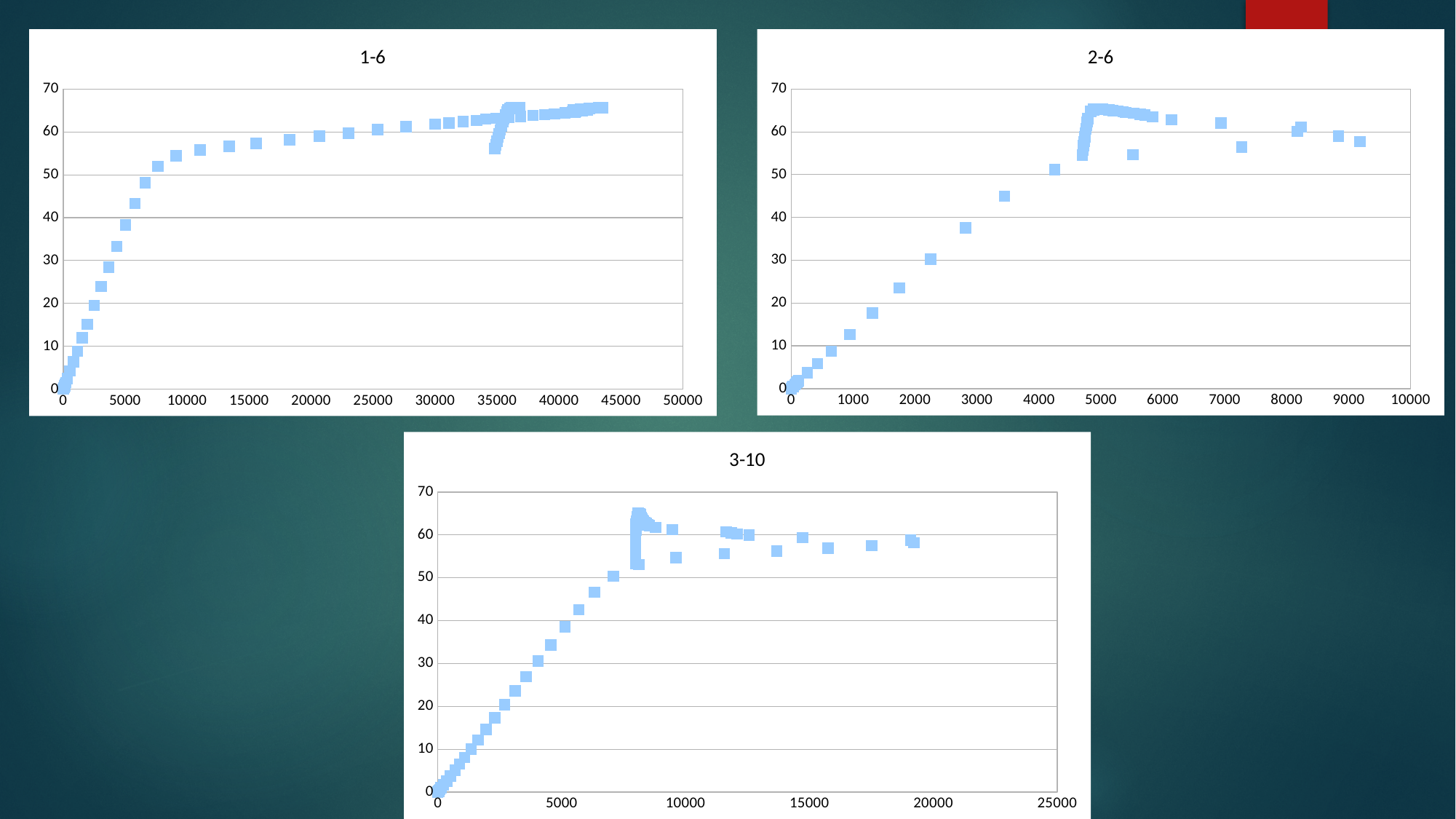
In the chart titled "1-6", what is the highest value shown on the x axis? 50000 In the chart titled "3-10", is the value at x = 10000 greater or less than 50? greater In the chart titled "3-10", is the value at x = 5000 greater or less than 50? less In the chart titled "2-6", do the values rise or fall as x increases from 0 to 4000? rise In the chart titled "1-6", is the value at x = 5000 greater or less than 30? greater How many charts are shown on the slide? 3 In the chart titled "1-6", do the values rise or fall as x increases from 0 to 10000? rise What are the titles of the three charts on the slide? 1-6, 2-6, 3-10 What kind of chart is the chart titled "1-6"? scatter chart